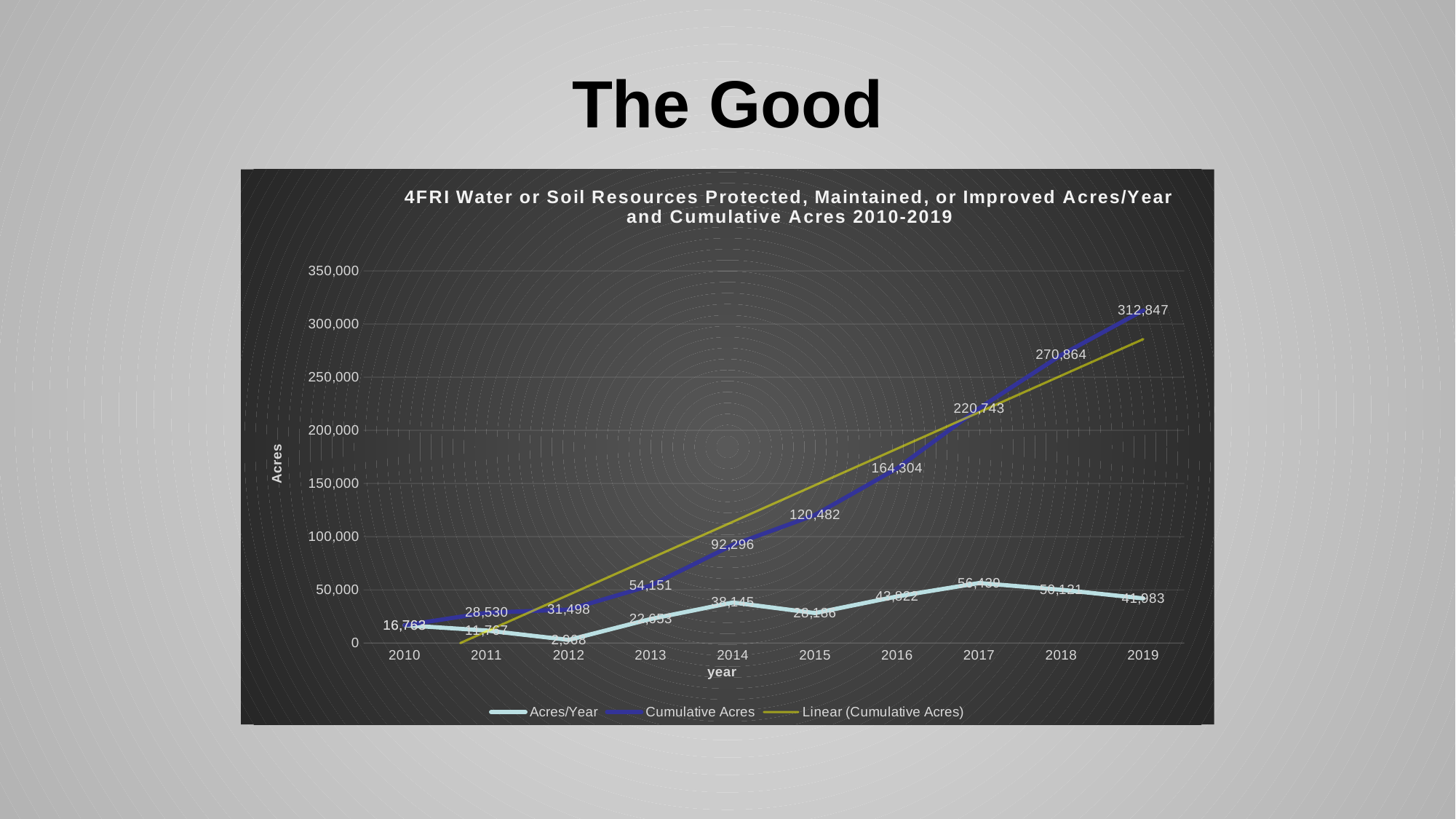
Does the Cumulative Acres series rise or fall from 2010 to 2019? rises Which year has the larger Acres/Year value, 2016 or 2019? 2016 In which year is the Acres/Year value highest? 2017 What is the Acres/Year value for 2014? 38,145 How many years are shown on the x axis? 10 What is the difference between the Cumulative Acres values for 2019 and 2018? 41,983 In which year is the Acres/Year value lowest? 2012 What is the Cumulative Acres value for 2019? 312,847 How many series does the legend list? 3 What is the Cumulative Acres value for 2016? 164,304 Is the Cumulative Acres value for 2017 greater or less than 200,000? greater What kind of chart is shown on the slide? line chart